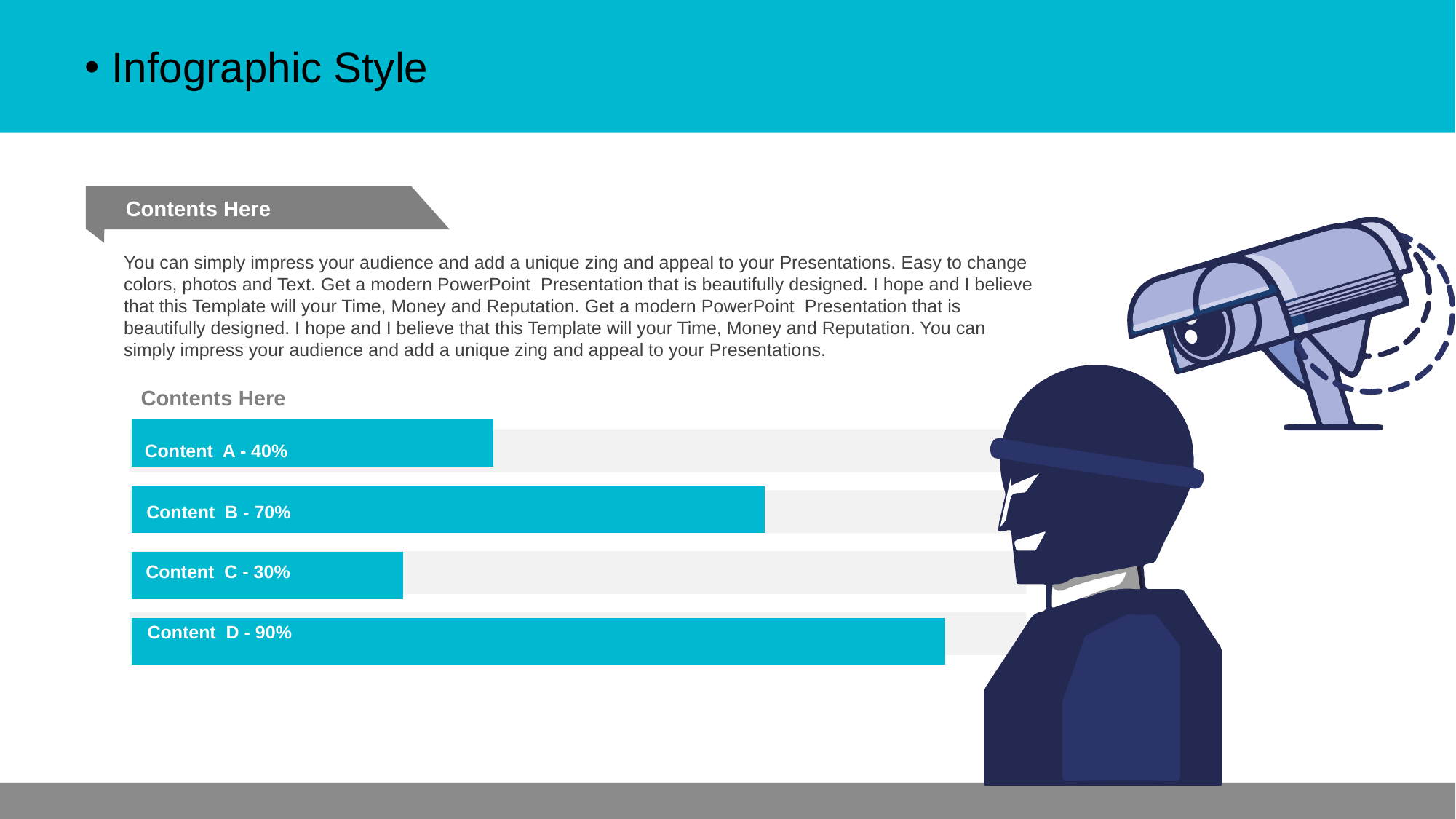
What is the value for Content C? 30% What is the value for Content A? 40% What is the difference between the values for Content D and Content A? 50% Which is larger, the value for Content A or the value for Content B? Content B What is the title shown above the bar chart? Contents Here What is the value for Content D? 90% What kind of chart is shown on the slide? Bar chart Which category has the highest value? Content D How many categories are shown in the bar chart? 4 What is the difference between the values for Content B and Content C? 40% Which category has the lowest value? Content C What is the value for Content B? 70%